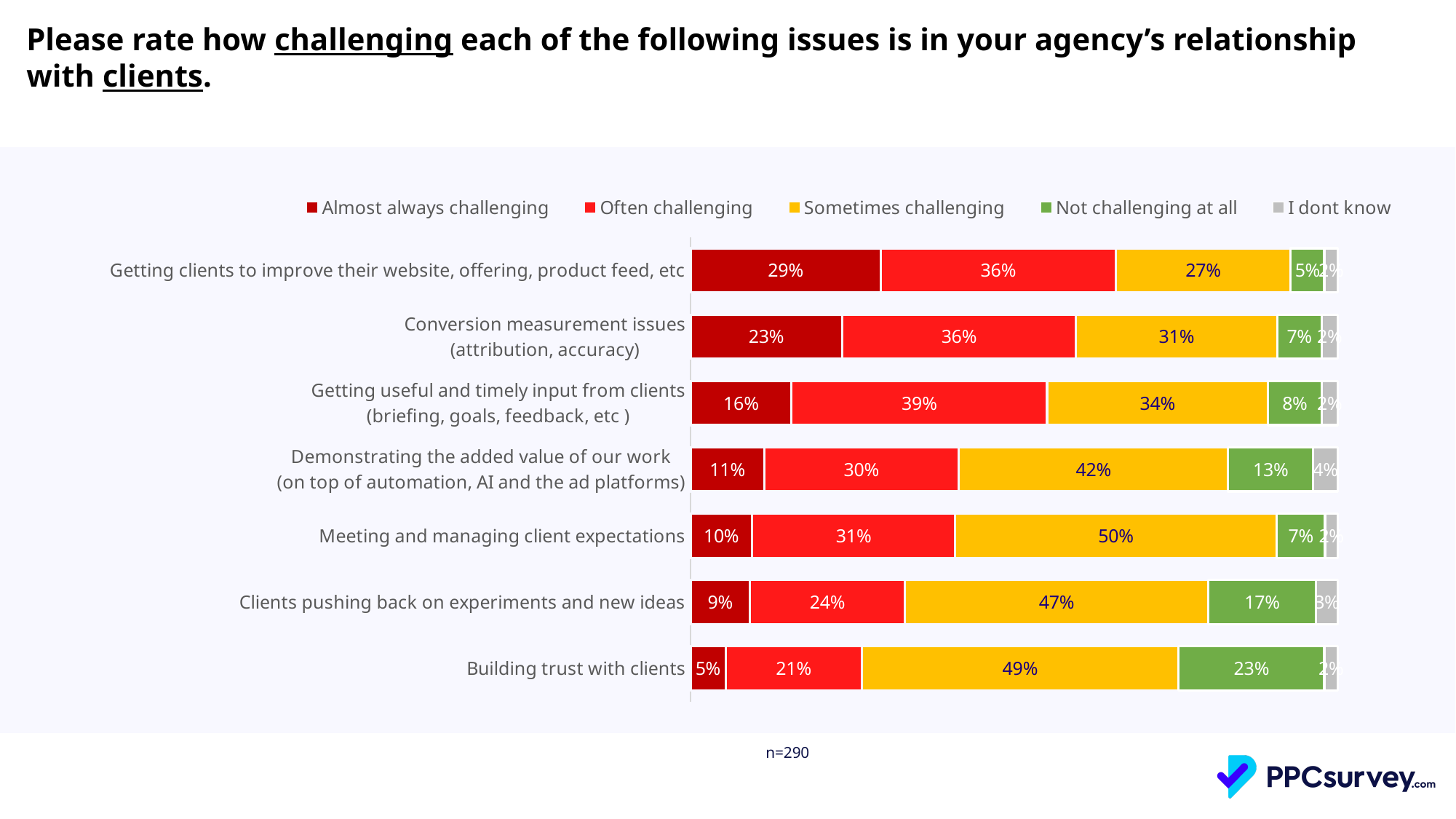
What percentage of respondents said 'Building trust with clients' is not challenging at all? 23% Which issue has the lowest share of 'Almost always challenging' responses? Building trust with clients What is the sample size shown below the chart? n=290 Which has a larger 'Not challenging at all' share: 'Clients pushing back on experiments and new ideas' or 'Conversion measurement issues'? Clients pushing back on experiments and new ideas What percentage of respondents said 'Meeting and managing client expectations' is sometimes challenging? 50% What is the difference between the 'Sometimes challenging' percentages for 'Meeting and managing client expectations' and 'Demonstrating the added value of our work'? 8% What percentage of respondents said 'Getting clients to improve their website, offering, product feed, etc' is almost always challenging? 29% How many response categories does the legend list? 5 What type of chart is shown on the slide? Stacked bar chart How many issues (categories) are shown in the chart? 7 Which issue has the highest share of 'Almost always challenging' responses? Getting clients to improve their website, offering, product feed, etc What percentage of respondents said 'Getting useful and timely input from clients' is often challenging? 39%